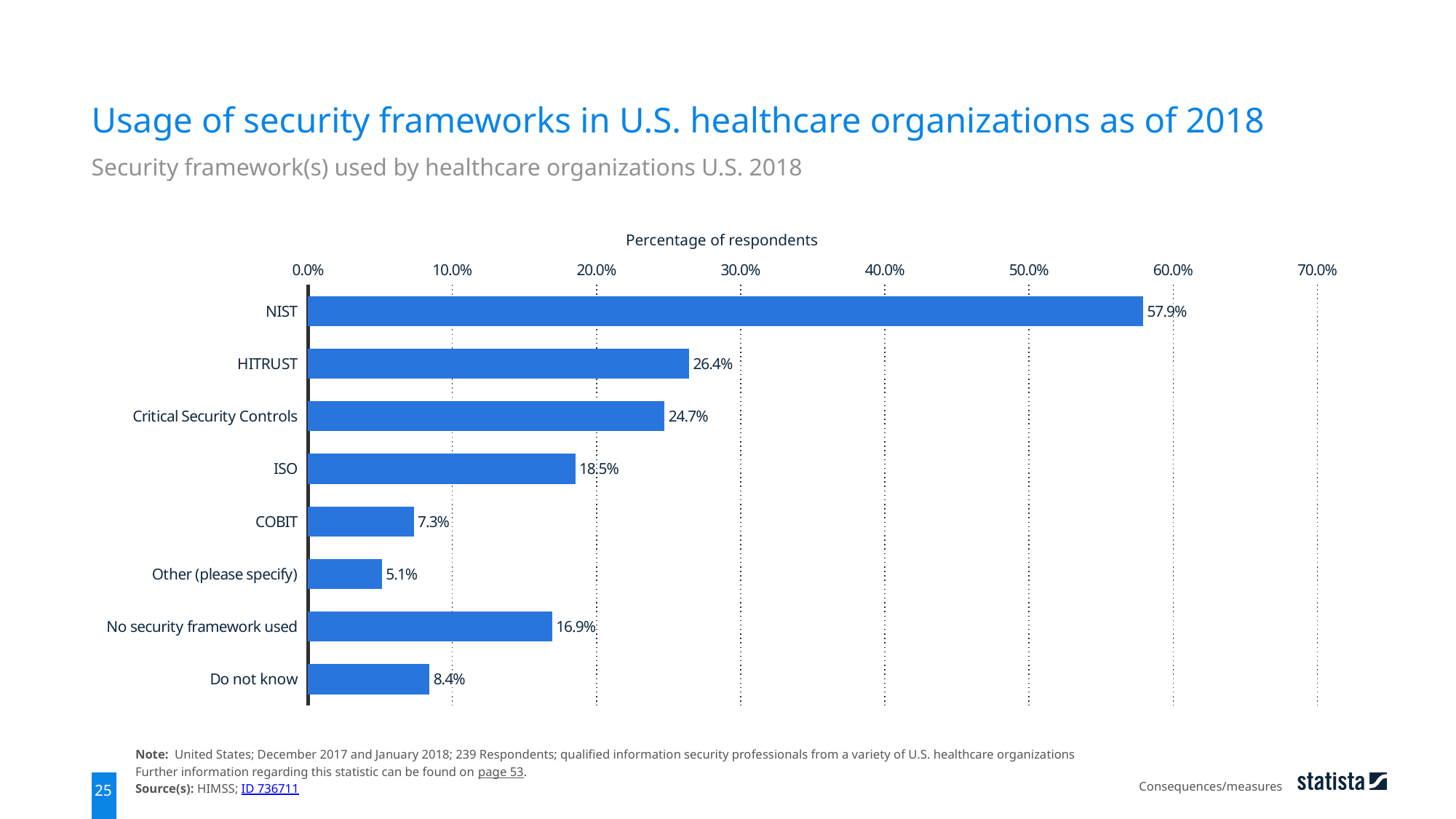
What is the value for Do not know? 8.4% Which security framework has the highest percentage of respondents? NIST Is the value for Critical Security Controls greater or less than 20.0%? greater How many categories are shown in the chart? 8 What is the label of the horizontal axis? Percentage of respondents What kind of chart is shown on the slide? Bar chart What percentage of respondents use the NIST security framework? 57.9% Which is larger, the value for ISO or the value for No security framework used? ISO What is the value for HITRUST? 26.4% What is the difference between the values for NIST and HITRUST? 31.5% What percentage of respondents reported no security framework used? 16.9% Which category has the lowest percentage of respondents? Other (please specify)